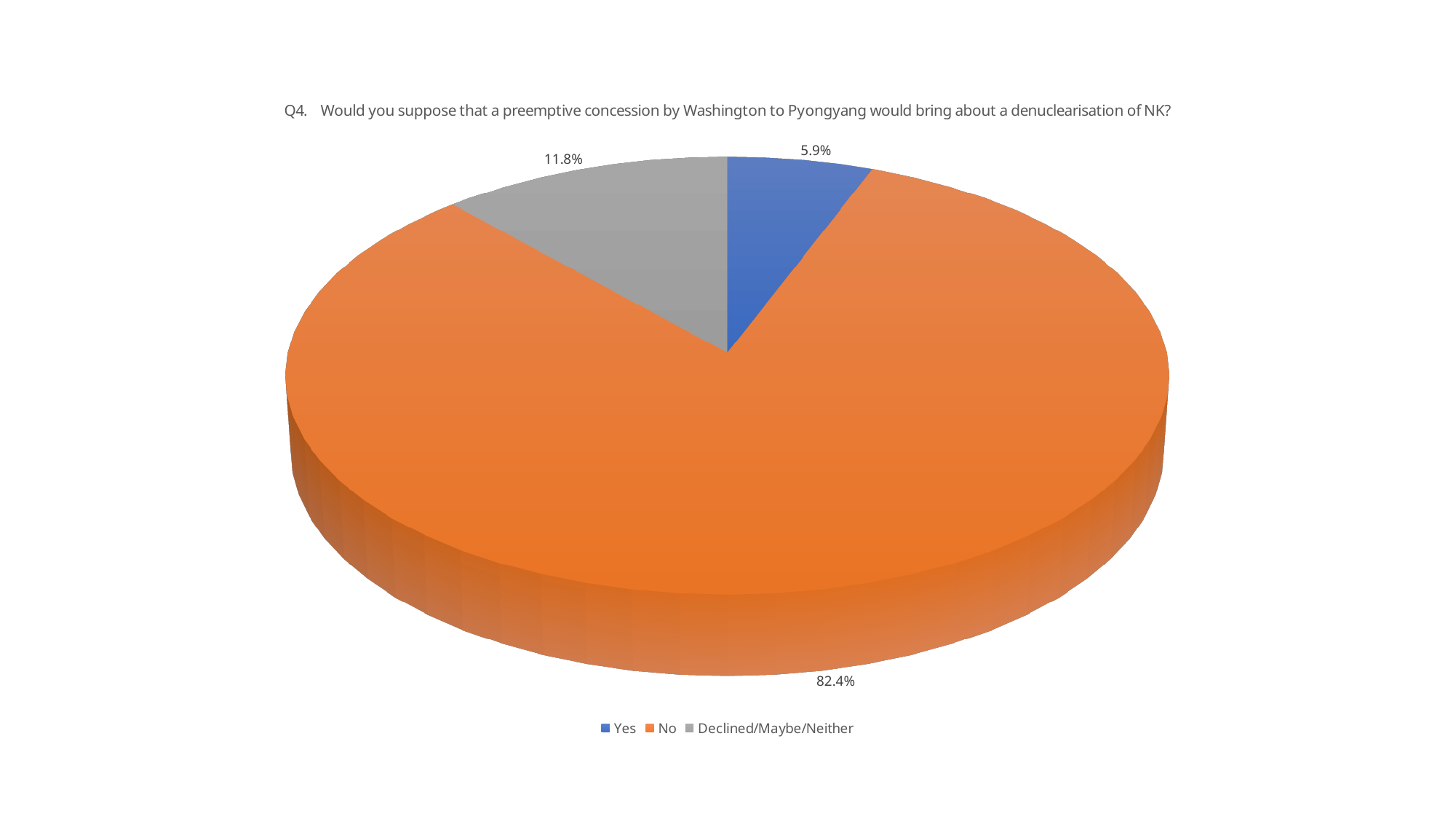
Which category has the largest slice of the pie? No What kind of chart is shown on the slide? Pie chart What colour is the "No" slice in the pie chart? Orange Which category has the smallest slice of the pie? Yes What is the title of the chart? Q4. Would you suppose that a preemptive concession by Washington to Pyongyang would bring about a denuclearisation of NK? Which is larger, the "Yes" slice or the "Declined/Maybe/Neither" slice? Declined/Maybe/Neither What share of the pie does the "Declined/Maybe/Neither" slice represent? 11.8% What is the difference in percentage points between the "No" slice and the "Declined/Maybe/Neither" slice? 70.6 How many entries does the legend list? 3 What share of the pie does the "No" slice represent? 82.4% How many slices does the pie chart have? 3 What share of the pie does the "Yes" slice represent? 5.9%